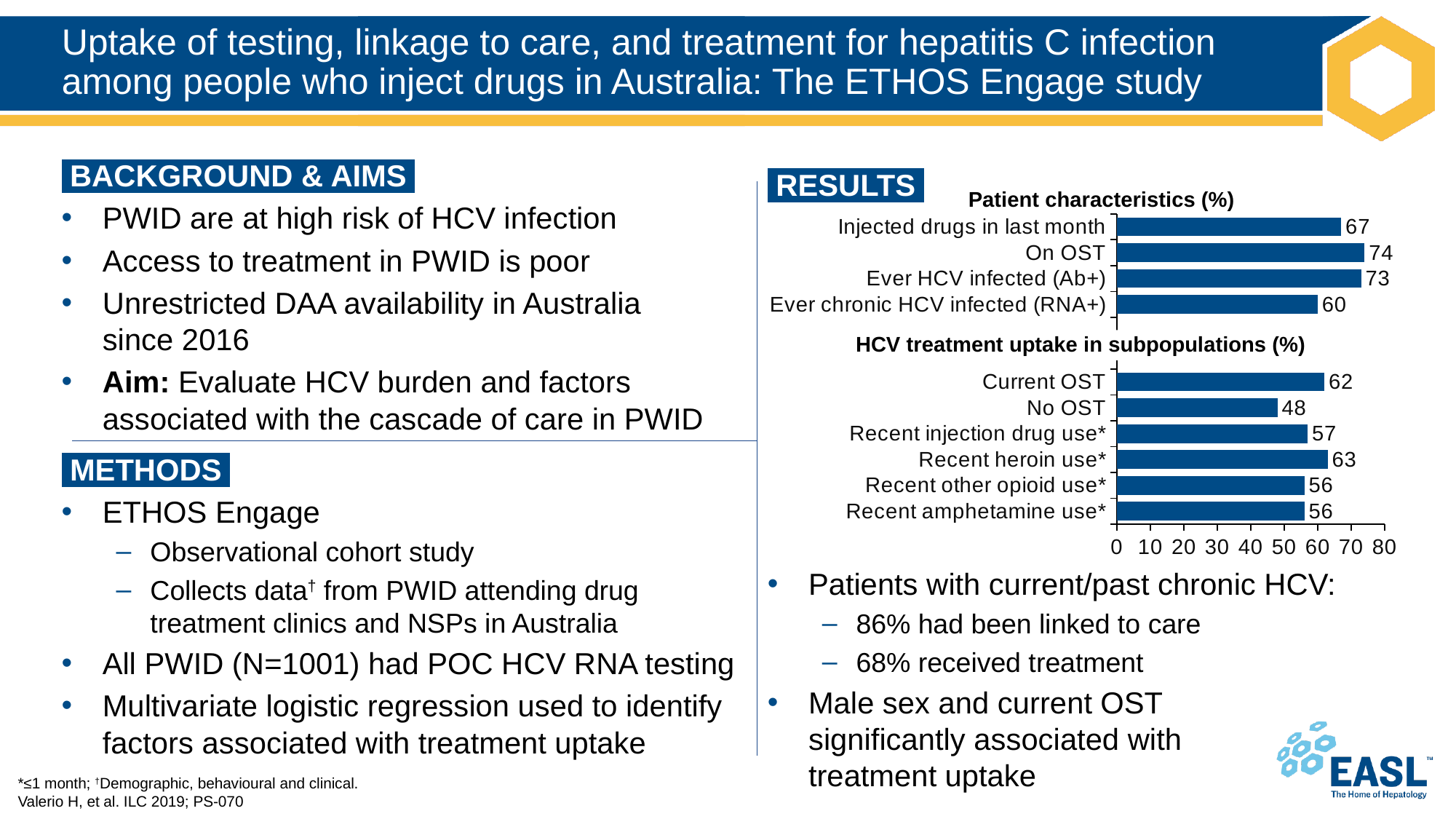
What type of chart is the 'HCV treatment uptake in subpopulations (%)' chart? Bar chart In the 'Patient characteristics (%)' chart, what is the value for 'Ever chronic HCV infected (RNA+)'? 60 In the 'Patient characteristics (%)' chart, how many categories are shown? 4 In the 'Patient characteristics (%)' chart, which category has the lowest value? Ever chronic HCV infected (RNA+) In the 'HCV treatment uptake in subpopulations (%)' chart, what is the value for 'Recent heroin use*'? 63 In the 'Patient characteristics (%)' chart, what is the difference between 'Injected drugs in last month' and 'Ever chronic HCV infected (RNA+)'? 7 In the 'HCV treatment uptake in subpopulations (%)' chart, which category has the lowest value? No OST In the 'HCV treatment uptake in subpopulations (%)' chart, what is the value for 'No OST'? 48 In the 'Patient characteristics (%)' chart, what is the value for 'On OST'? 74 In the 'HCV treatment uptake in subpopulations (%)' chart, which is larger: 'Current OST' or 'No OST'? Current OST In the 'HCV treatment uptake in subpopulations (%)' chart, how many categories are shown? 6 In the 'HCV treatment uptake in subpopulations (%)' chart, what is the difference between 'Current OST' and 'No OST'? 14